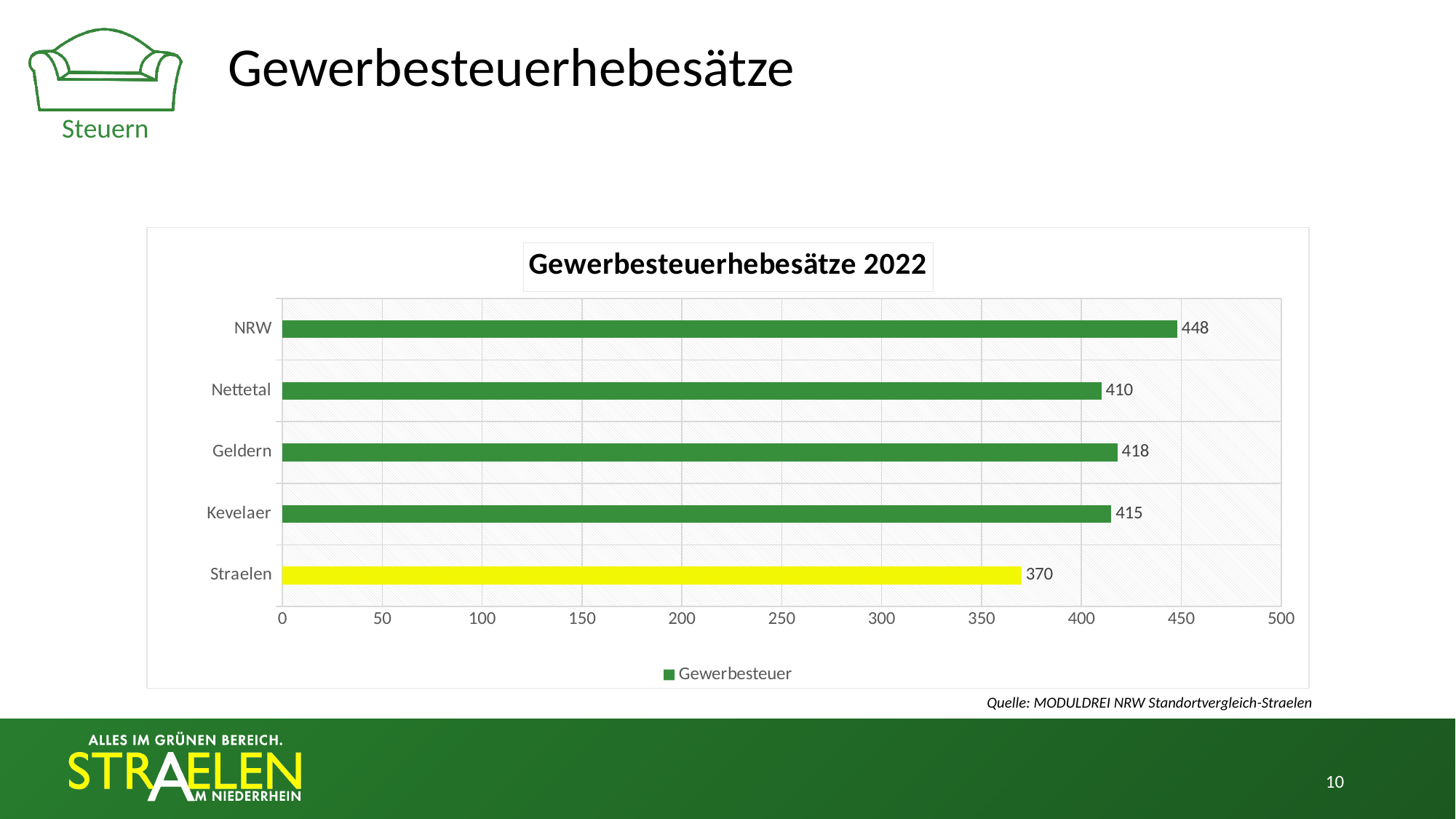
What is the title of the chart? Gewerbesteuerhebesätze 2022 What is the difference between the values for Geldern and Nettetal? 8 Which category has the lowest Gewerbesteuer value? Straelen What kind of chart is shown on the slide? Bar chart What is the difference between the values for NRW and Straelen? 78 What is the Gewerbesteuer value for NRW? 448 Is the value for Nettetal greater or less than 400? greater Which has a larger value, Kevelaer or Straelen? Kevelaer How many categories are shown in the chart? 5 What is the Gewerbesteuer value for Geldern? 418 What is the Gewerbesteuer value for Straelen? 370 Which category has the highest Gewerbesteuer value? NRW